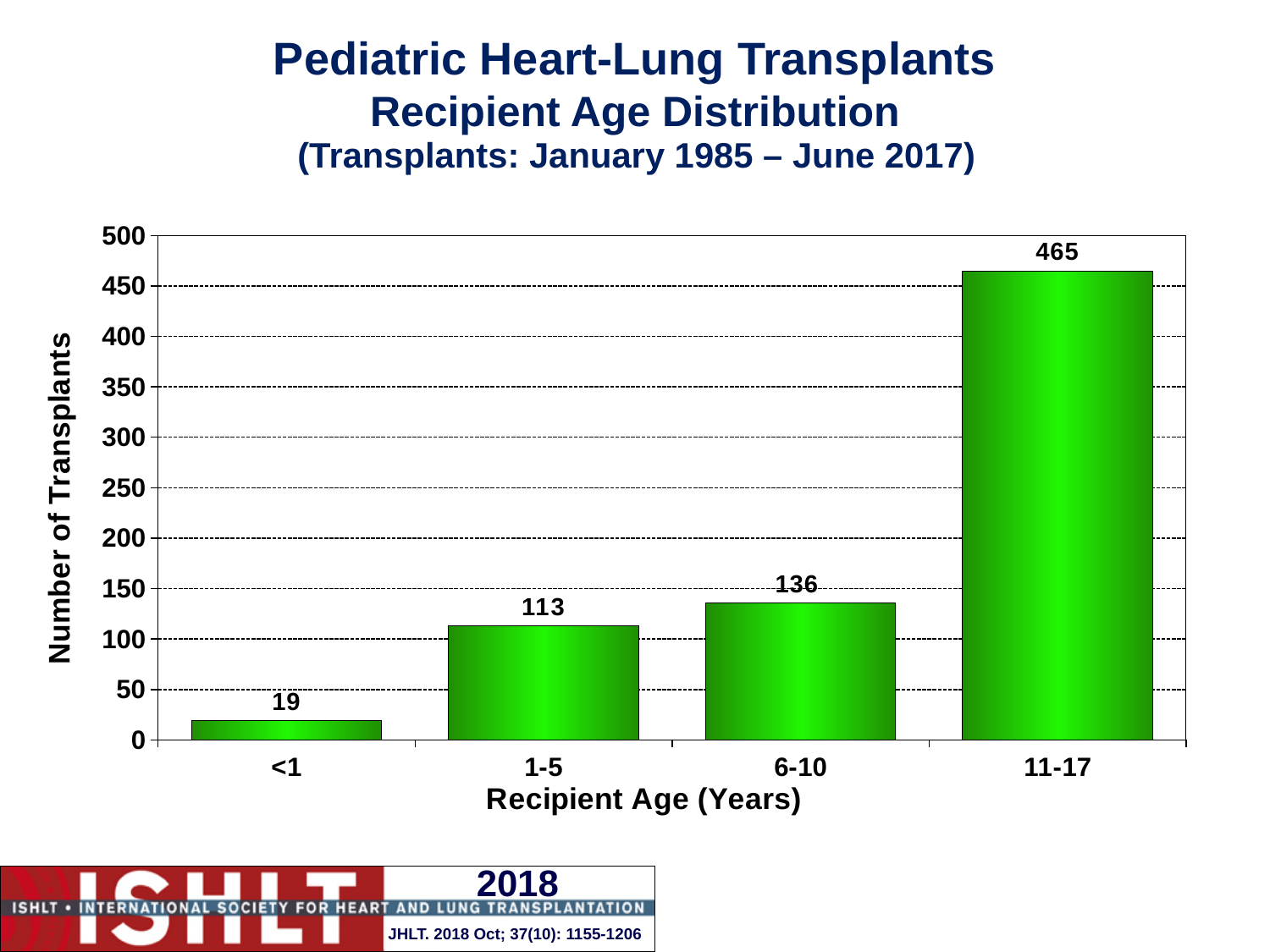
How many transplants were performed for recipients aged <1 year? 19 Do the number of transplants rise or fall as recipient age increases along the x axis? Rise How many recipient age groups are shown on the chart? 4 What is the number of transplants for the 1-5 age group? 113 What is the difference in number of transplants between the 11-17 and 6-10 age groups? 329 What type of chart is shown on the slide? Bar chart Which recipient age group has the lowest number of transplants? <1 Which age group has more transplants, 1-5 or 6-10? 6-10 What is the number of transplants for the 6-10 age group? 136 What is the number of transplants for the 11-17 age group? 465 What is the difference in number of transplants between the 6-10 and 1-5 age groups? 23 Which recipient age group has the highest number of transplants? 11-17